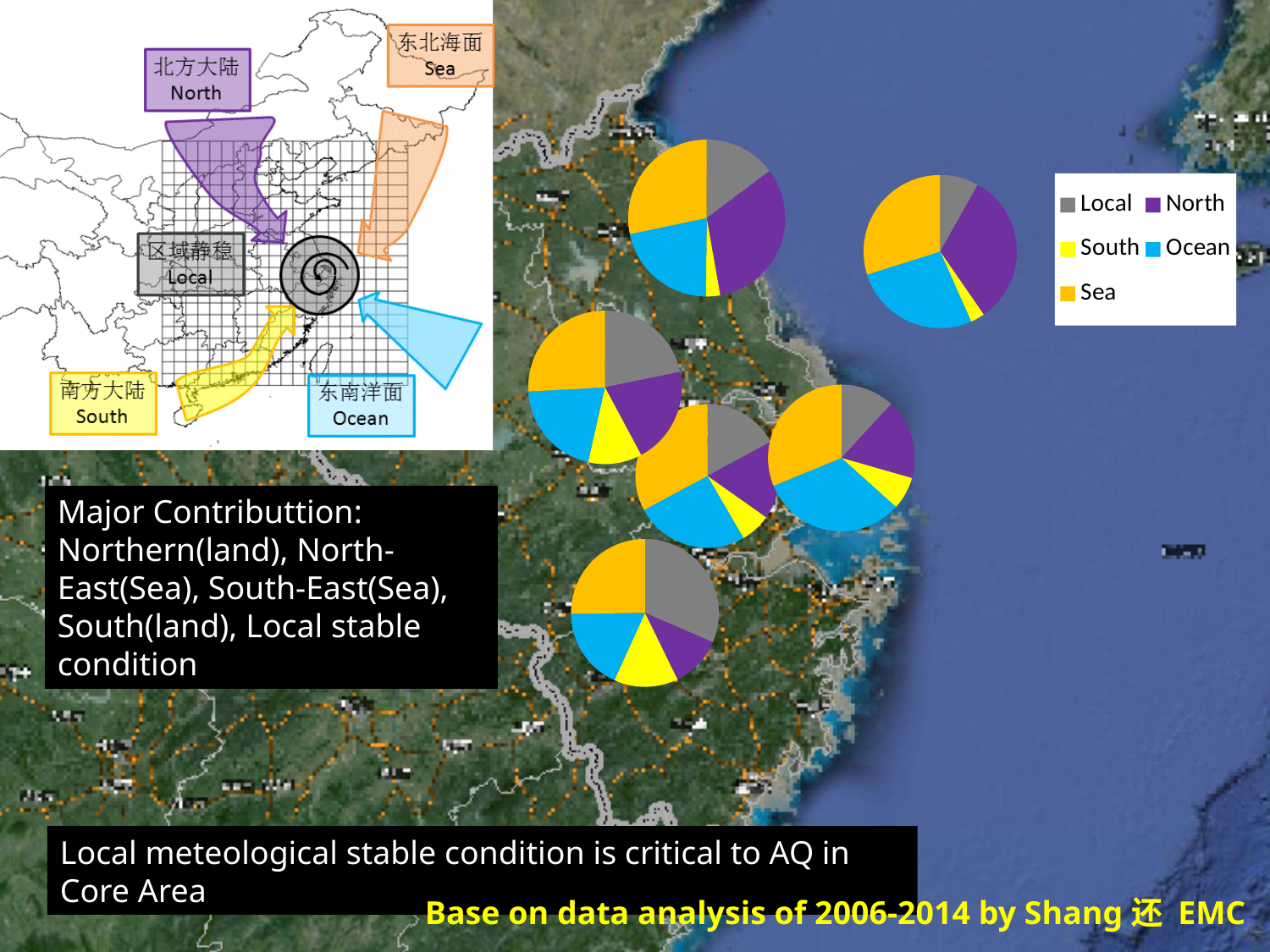
What kind of charts are plotted over the map on the slide? Pie charts In the pie chart at the top right of the group (the one nearest the legend), which category has the smallest slice? South In the pie chart in the middle of the group (the one just below the top-left pie), which category has the smallest slice? South In the bottom-most pie chart, is the Local slice larger or smaller than the North slice? Larger How many pie charts are shown on the map? 6 In the pie chart at the top left of the group (the one nearest the inset map), which category has the smallest slice? South How many categories does the legend list for the pie charts? 5 In the pie chart at the top left of the group, is the North slice larger or smaller than the South slice? Larger Which colour represents the Sea category in the pie charts? Orange In the pie chart at the top right of the group (nearest the legend), is the South slice larger or smaller than the Sea slice? Smaller Which category is shown in purple in the pie charts? North